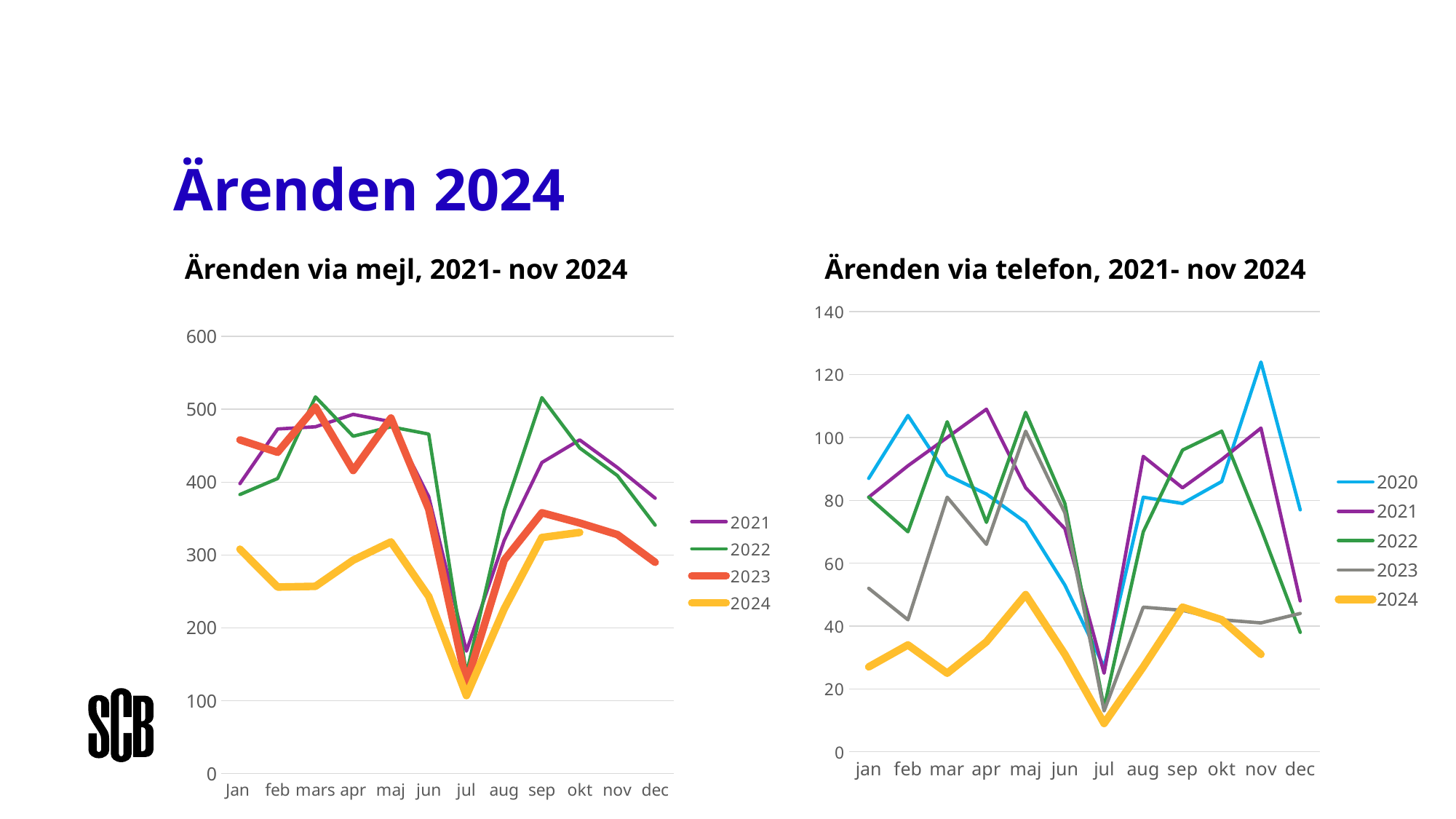
In 'Ärenden via telefon, 2021- nov 2024', is the value for 2020 in nov greater or less than 100? greater In 'Ärenden via mejl, 2021- nov 2024', which series has the lowest value in Jan? 2024 In 'Ärenden via telefon, 2021- nov 2024', which series has the highest value in nov? 2020 What type of chart is 'Ärenden via mejl, 2021- nov 2024'? line chart In 'Ärenden via mejl, 2021- nov 2024', does the 2024 line rise or fall from jun to jul? fall How many series does the legend of 'Ärenden via telefon, 2021- nov 2024' list? 5 How many months are shown on the x axis of 'Ärenden via telefon, 2021- nov 2024'? 12 In 'Ärenden via mejl, 2021- nov 2024', is the value for 2022 in sep greater or less than 500? greater How many series does the legend of 'Ärenden via mejl, 2021- nov 2024' list? 4 In 'Ärenden via telefon, 2021- nov 2024', is the value for 2024 in jul greater or less than 20? less Which series is drawn in yellow in 'Ärenden via telefon, 2021- nov 2024'? 2024